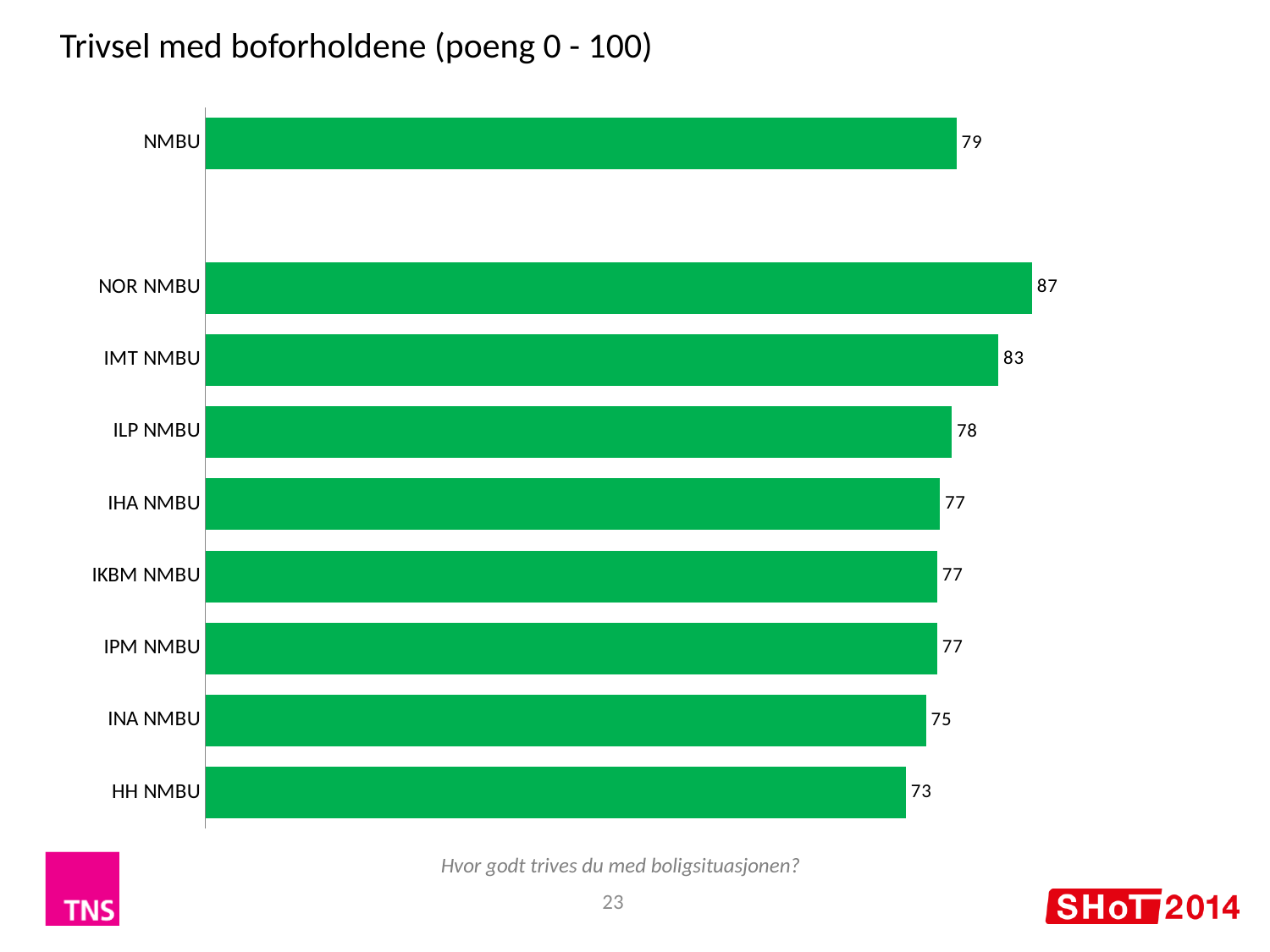
What kind of chart is shown on the slide? Bar chart Which category has the highest value? NOR NMBU Which is larger, the value for INA NMBU or the value for IPM NMBU? IPM NMBU What is the value for NOR NMBU? 87 What is the difference between the values for IMT NMBU and ILP NMBU? 5 What is the value for NMBU? 79 Which category has the lowest value? HH NMBU How many categories are shown in the chart? 9 What is the title of the chart? Trivsel med boforholdene (poeng 0 - 100) What is the value for IMT NMBU? 83 What is the difference between the values for NOR NMBU and HH NMBU? 14 What is the value for HH NMBU? 73